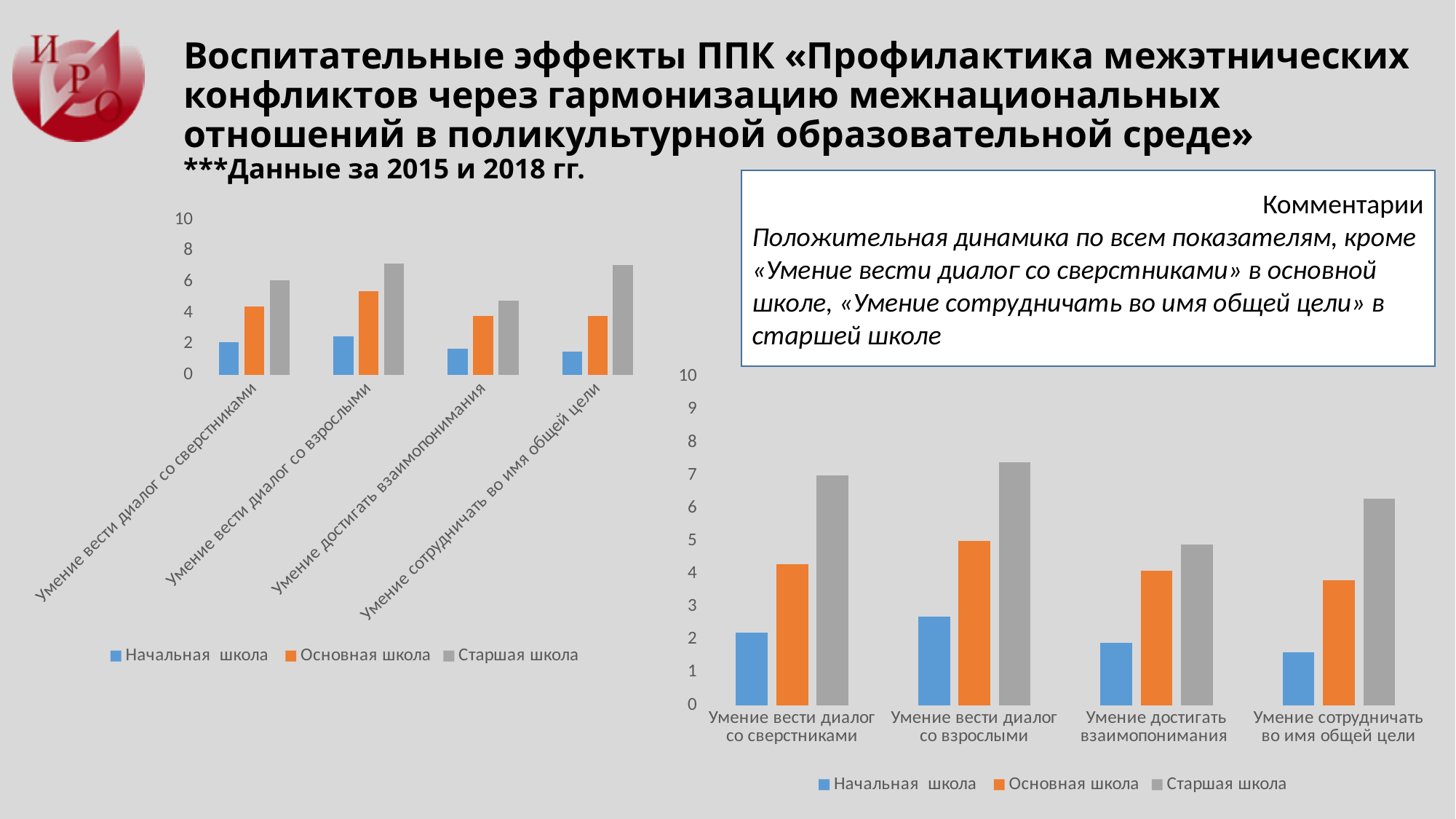
In the left chart, for Начальная школа, which is larger: «Умение вести диалог со сверстниками» or «Умение вести диалог со взрослыми»? Умение вести диалог со взрослыми In the right chart, which category has the lowest value for Старшая школа? Умение достигать взаимопонимания In the right chart, which category has the highest value for Основная школа? Умение вести диалог со взрослыми In the right chart, which series is shown in orange? Основная школа In the right chart, is the value for Начальная школа in «Умение вести диалог со сверстниками» greater or less than 2? greater How many categories are shown on the x axis of the right chart? 4 How many series does the legend of the right chart list? 3 What type of chart is the chart on the left side of the slide? bar chart In the right chart, is the value for Старшая школа in «Умение сотрудничать во имя общей цели» greater or less than 6? greater In the right chart, is the value for Основная школа in «Умение сотрудничать во имя общей цели» greater or less than 4? less In the right chart, for «Умение достигать взаимопонимания», which is larger: Основная школа or Старшая школа? Старшая школа